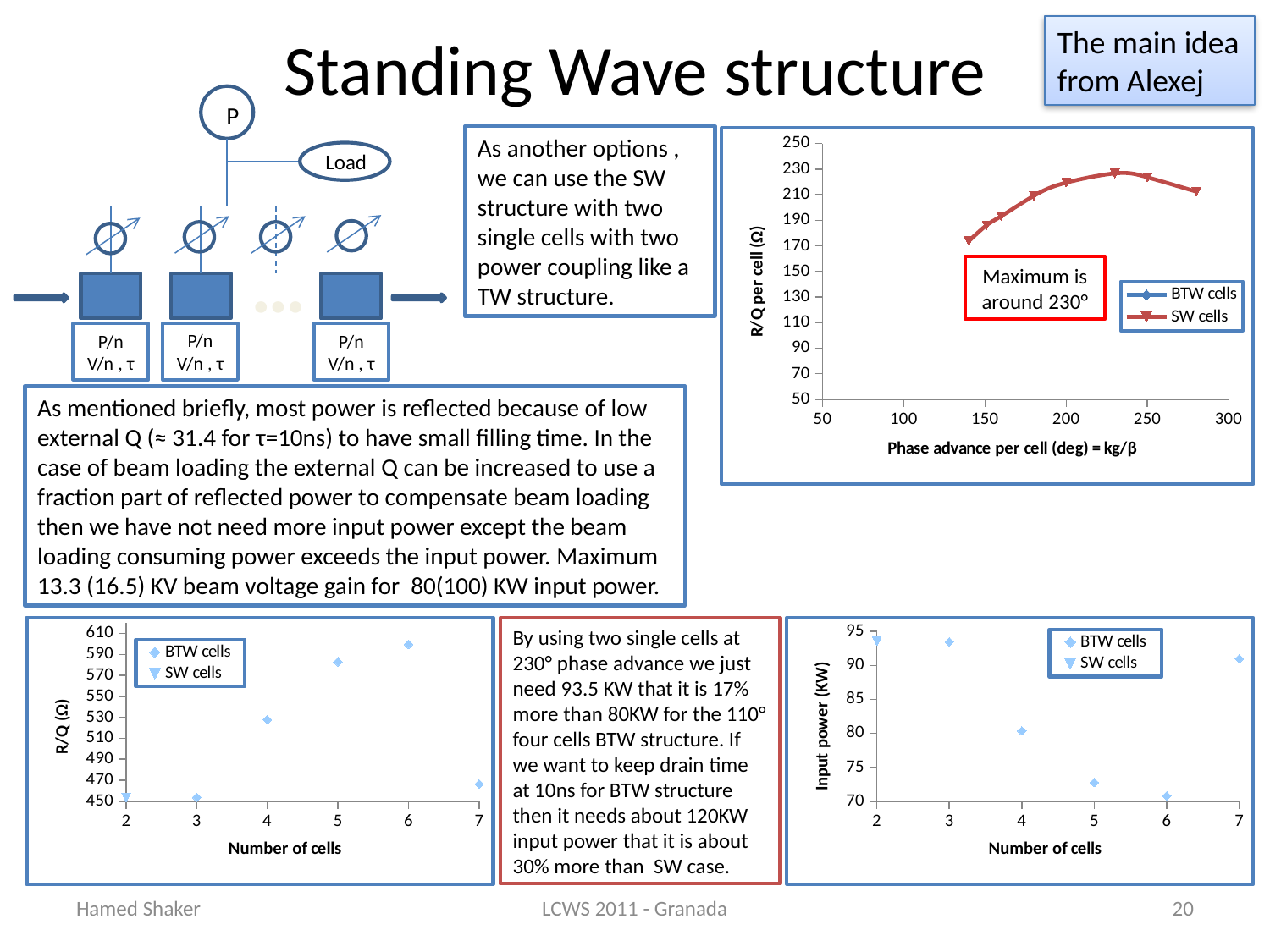
In the bottom-right chart of input power versus number of cells, at which number of cells is the BTW cells input power lowest? 6 In the bottom-left chart, which has the larger BTW cells R/Q value: 5 cells or 7 cells? 5 cells In the bottom-left chart, how many BTW cells data points are plotted? 5 What is the x-axis title of the top-right chart? Phase advance per cell (deg) = kg/β In the top-right chart, is the SW cells value at a phase advance of 140 greater or less than 190? less In the bottom-right chart, is the BTW cells input power at 4 cells greater or less than 85? less In the bottom-left chart of R/Q versus number of cells, at which number of cells is the BTW cells value highest? 6 In the top-right chart, is the SW cells value at a phase advance of 230 greater or less than 210? greater In the bottom-right chart, does the BTW cells input power rise or fall as the number of cells goes from 3 to 6? fall How many series does the legend of the top-right chart (R/Q per cell) list? 2 What kind of chart is the top-right chart of R/Q per cell versus phase advance per cell? line chart